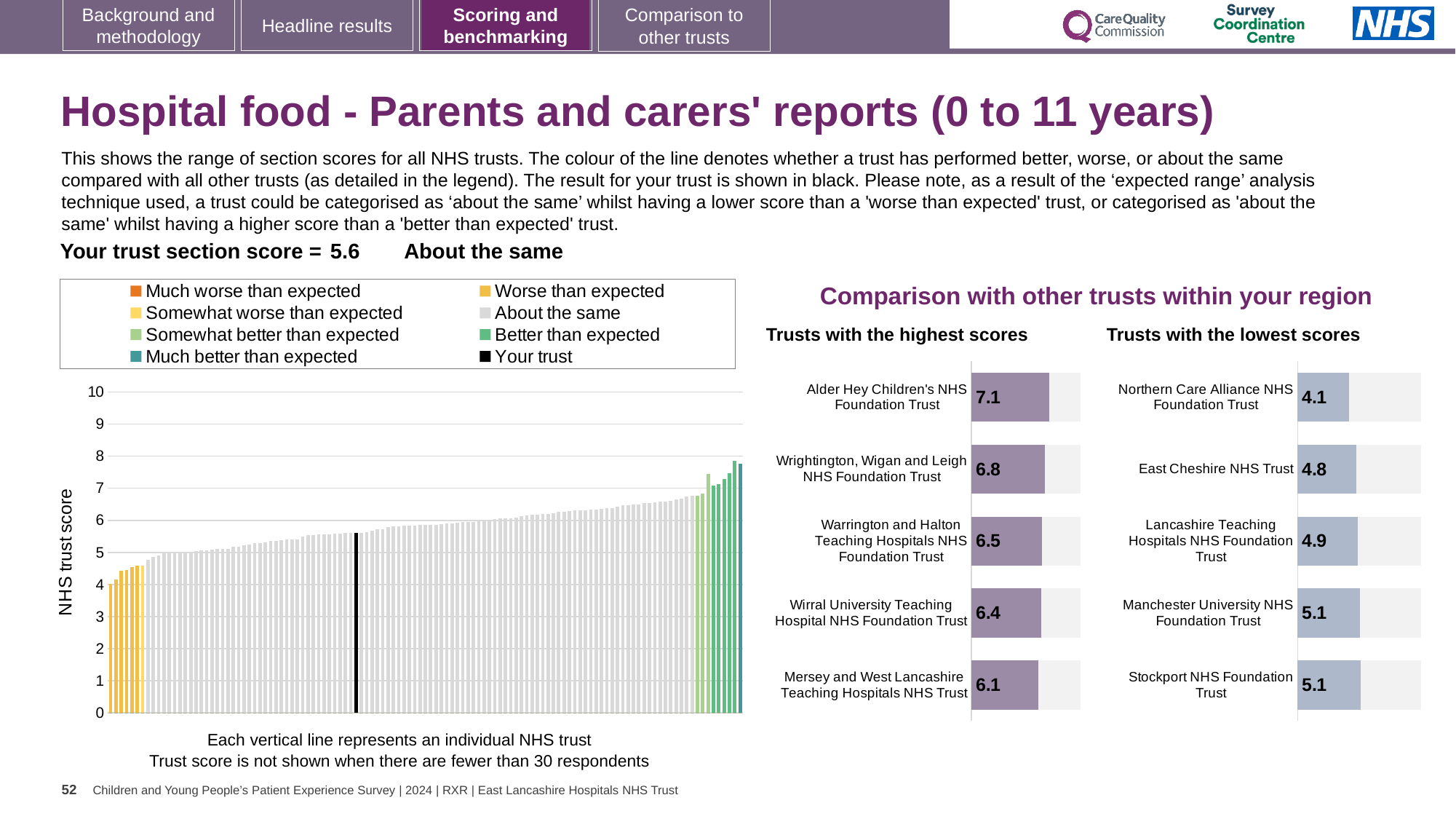
In the 'Trusts with the highest scores' chart, which trust has the lowest score? Mersey and West Lancashire Teaching Hospitals NHS Trust In the main chart on the left, is the value for the black 'Your trust' bar greater or less than 5? greater What type of chart is the main chart on the left showing NHS trust scores? Bar chart In the 'Trusts with the lowest scores' chart, which has the larger score: East Cheshire NHS Trust or Lancashire Teaching Hospitals NHS Foundation Trust? Lancashire Teaching Hospitals NHS Foundation Trust In the 'Trusts with the lowest scores' chart, what is the score for Northern Care Alliance NHS Foundation Trust? 4.1 In the 'Trusts with the lowest scores' chart, what is the difference between the scores of East Cheshire NHS Trust and Northern Care Alliance NHS Foundation Trust? 0.7 In the 'Trusts with the highest scores' chart, what is the score for Wirral University Teaching Hospital NHS Foundation Trust? 6.4 How many entries does the legend of the main chart on the left list? 8 How many trusts are shown in the 'Trusts with the lowest scores' chart? 5 In the 'Trusts with the highest scores' chart, what is the difference between the scores of Alder Hey Children's NHS Foundation Trust and Mersey and West Lancashire Teaching Hospitals NHS Trust? 1.0 In the 'Trusts with the lowest scores' chart, which trust has the lowest score? Northern Care Alliance NHS Foundation Trust In the 'Trusts with the highest scores' chart, what is the score for Alder Hey Children's NHS Foundation Trust? 7.1